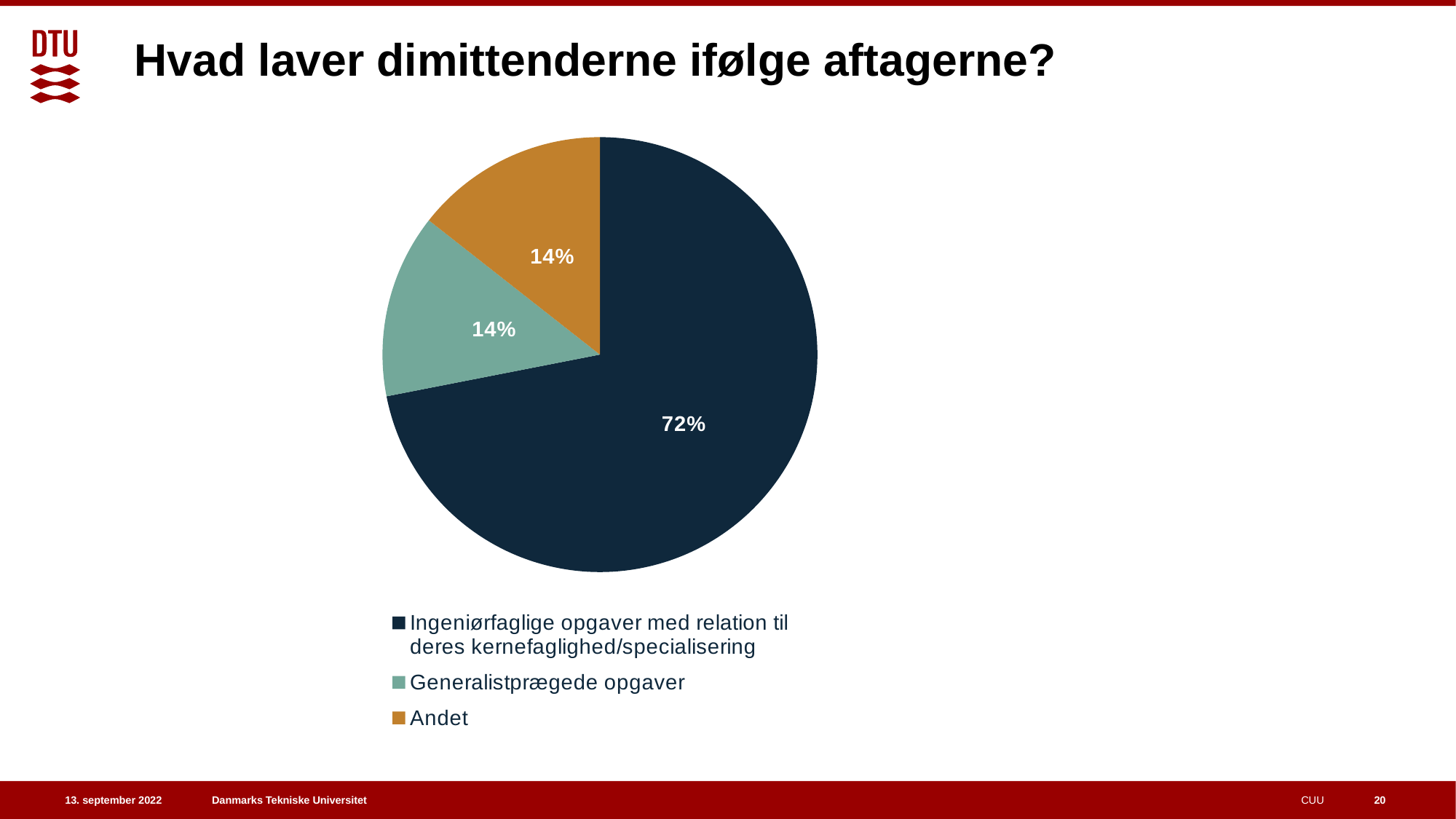
How many slices does the pie chart have? 3 What is the combined share of 'Generalistprægede opgaver' and 'Andet'? 28% How many entries does the legend list? 3 What is the title of the slide containing the pie chart? Hvad laver dimittenderne ifølge aftagerne? Which is larger: the slice for 'Ingeniørfaglige opgaver med relation til deres kernefaglighed/specialisering' or the slice for 'Generalistprægede opgaver'? Ingeniørfaglige opgaver med relation til deres kernefaglighed/specialisering What is the difference in percentage points between the 'Ingeniørfaglige opgaver' slice and the 'Andet' slice? 58 What share of the pie is labelled for 'Ingeniørfaglige opgaver med relation til deres kernefaglighed/specialisering'? 72% What colour is the slice for 'Andet'? orange What share of the pie is labelled for 'Generalistprægede opgaver'? 14% What kind of chart is shown on the slide? pie chart Which category has the largest slice of the pie? Ingeniørfaglige opgaver med relation til deres kernefaglighed/specialisering What share of the pie is labelled for 'Andet'? 14%